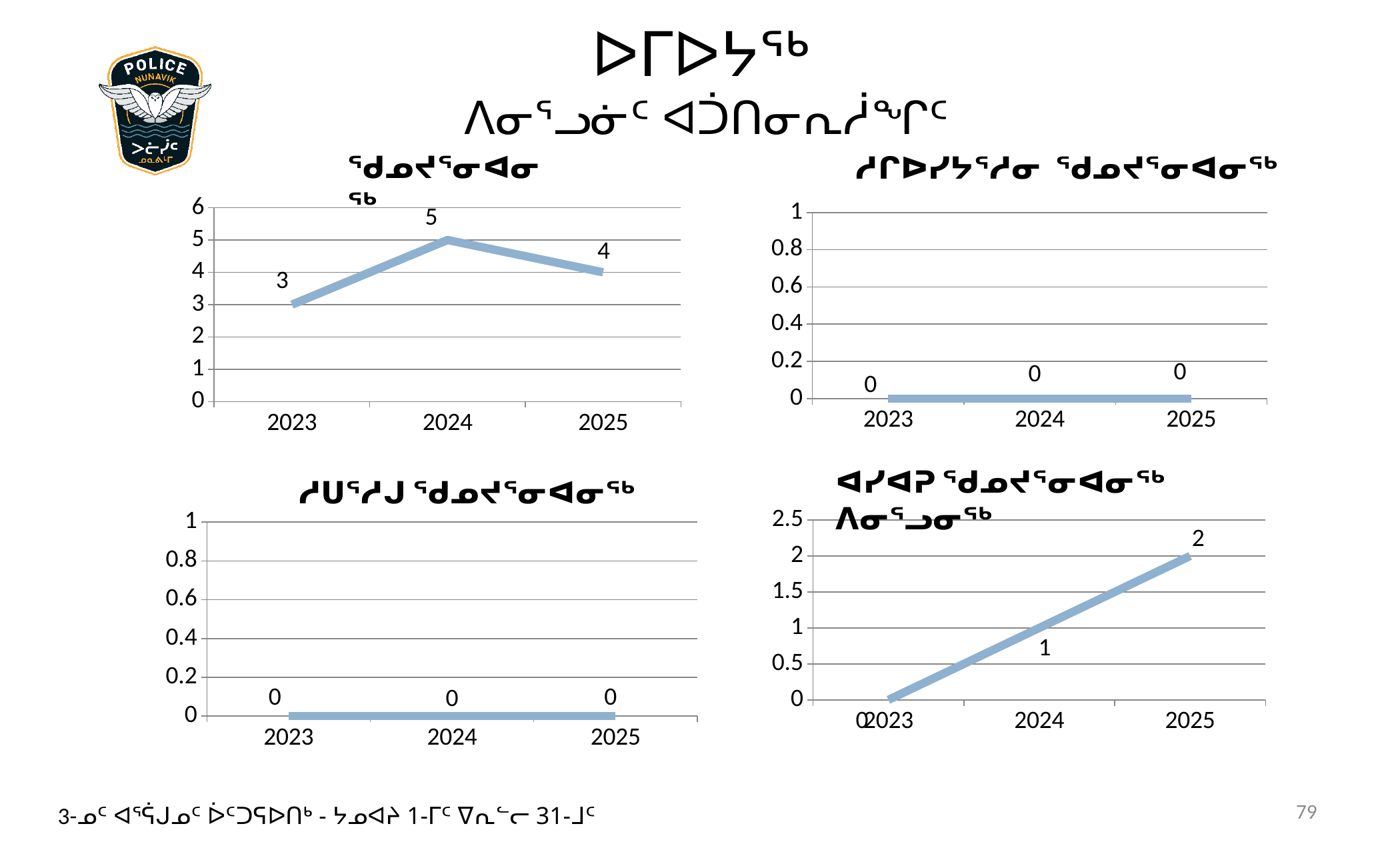
In the top-left chart, which year has the highest value? 2024 How many years are plotted in the bottom-left chart? 3 In the top-left chart, what is the value for 2023? 3 In the top-right chart, what is the value for 2024? 0 In the bottom-right chart, which is larger, the value for 2024 or the value for 2025? 2025 In the top-left chart, which year has the lowest value? 2023 In the top-left chart, is the value for 2025 greater or less than 3? greater In the bottom-right chart, do the values rise or fall from 2023 to 2025? rise In the top-left chart, what is the difference between the values for 2024 and 2025? 1 What kind of chart is the top-left chart? line chart In the top-left chart, what is the value for 2024? 5 In the bottom-right chart, what is the value for 2025? 2